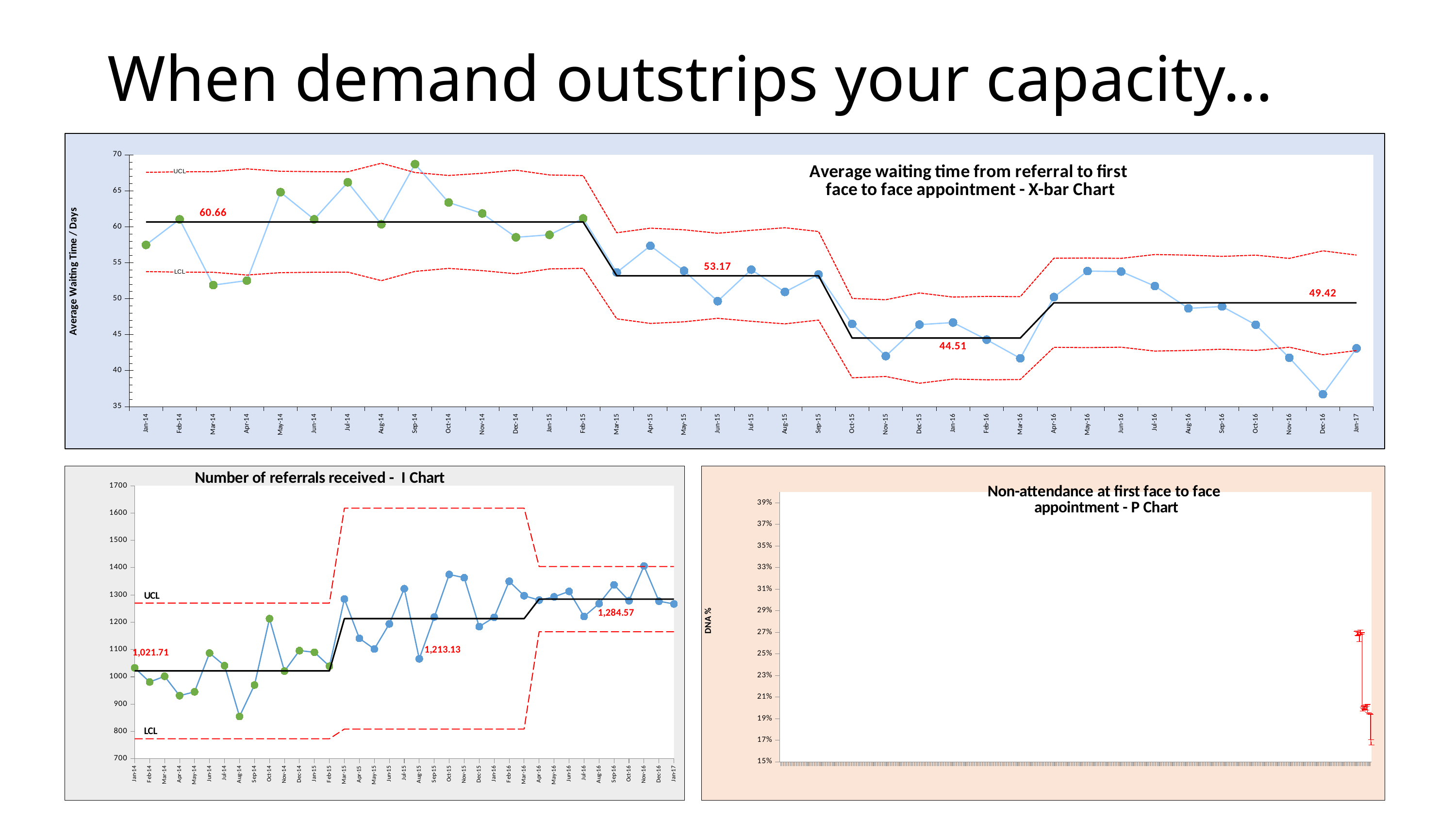
In the 'Number of referrals received - I Chart', is the value for Aug-14 greater or less than 900? less In the 'Number of referrals received - I Chart', what is the value printed on the first centre line? 1,021.71 In the X-bar chart of average waiting time, is the value for Sep-14 greater or less than 65? greater In the X-bar chart of average waiting time, what is the value printed on the last (rightmost) centre line? 49.42 In the X-bar chart of average waiting time, what is the difference between the first centre-line value (60.66) and the last centre-line value (49.42)? 11.24 In the X-bar chart of average waiting time, is the value for Dec-16 greater or less than 40? less In the X-bar chart of average waiting time, which printed centre-line value is the lowest? 44.51 What is the y-axis label of the 'Non-attendance at first face to face appointment - P Chart'? DNA % In the 'Number of referrals received - I Chart', what is the difference between the last centre-line value (1,284.57) and the first centre-line value (1,021.71)? 262.86 In the X-bar chart of average waiting time, what is the value printed on the first (leftmost) centre line? 60.66 What kind of chart is the 'Average waiting time from referral to first face to face appointment - X-bar Chart'? line chart In the X-bar chart of average waiting time, which month has the higher value: Sep-14 or Dec-16? Sep-14